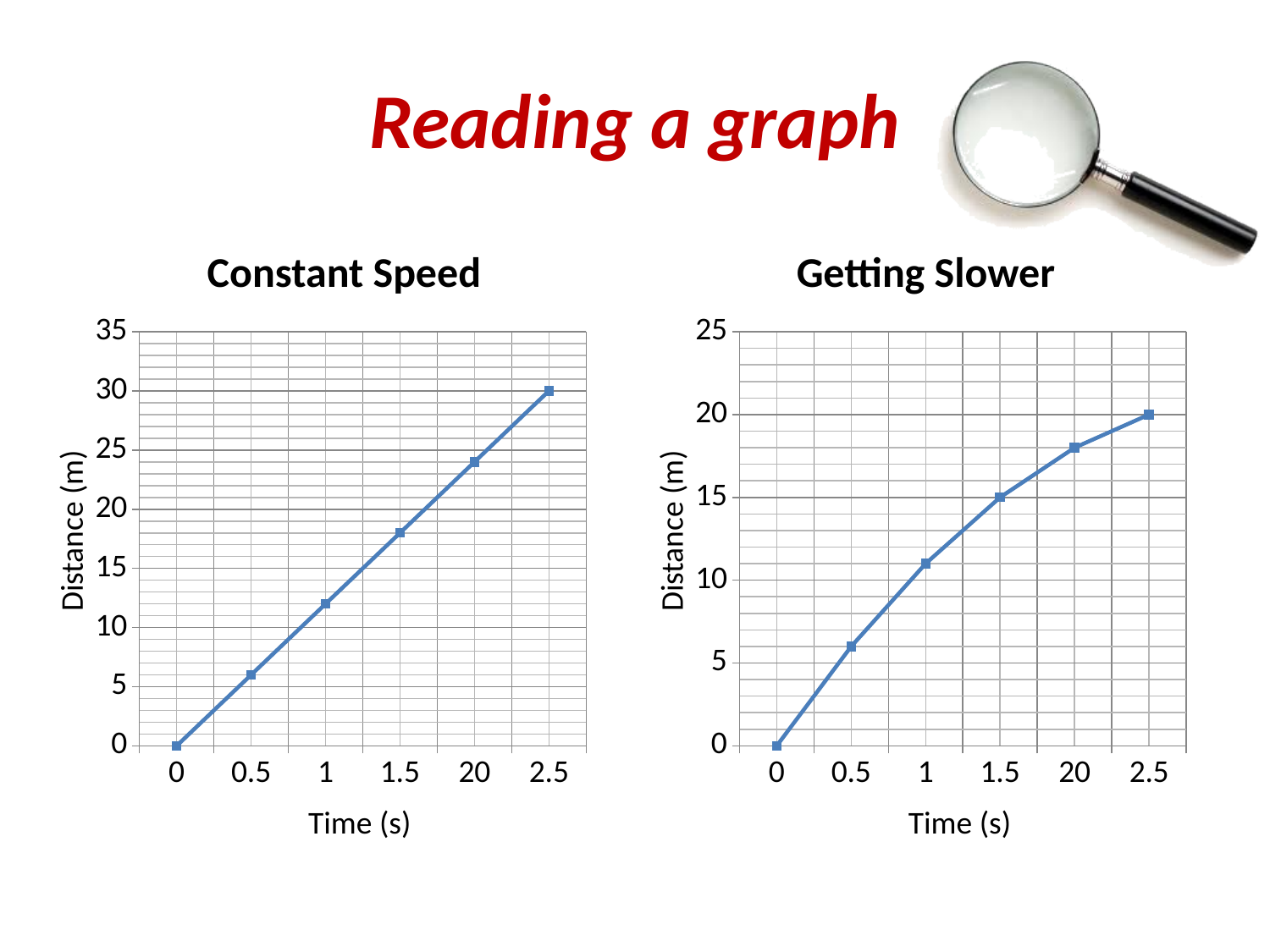
On the Getting Slower chart, do the distance values rise or fall as time increases? rise On the Constant Speed chart, at which time is the distance highest? 2.5 On the Getting Slower chart, what is the distance at time 2.5 s? 20 On the Getting Slower chart, is the distance at time 0.5 s greater or less than 10? less On the Constant Speed chart, is the distance at time 1 s greater or less than 10? greater What is the y-axis label on the Constant Speed chart? Distance (m) On the Getting Slower chart, what is the distance at time 1.5 s? 15 On the Constant Speed chart, how many data points are plotted? 6 On the Constant Speed chart, what is the distance at time 2.5 s? 30 Which chart reaches a higher final distance at 2.5 s, Constant Speed or Getting Slower? Constant Speed On the Getting Slower chart, at which time is the distance lowest? 0 What kind of chart is the Getting Slower chart? line chart